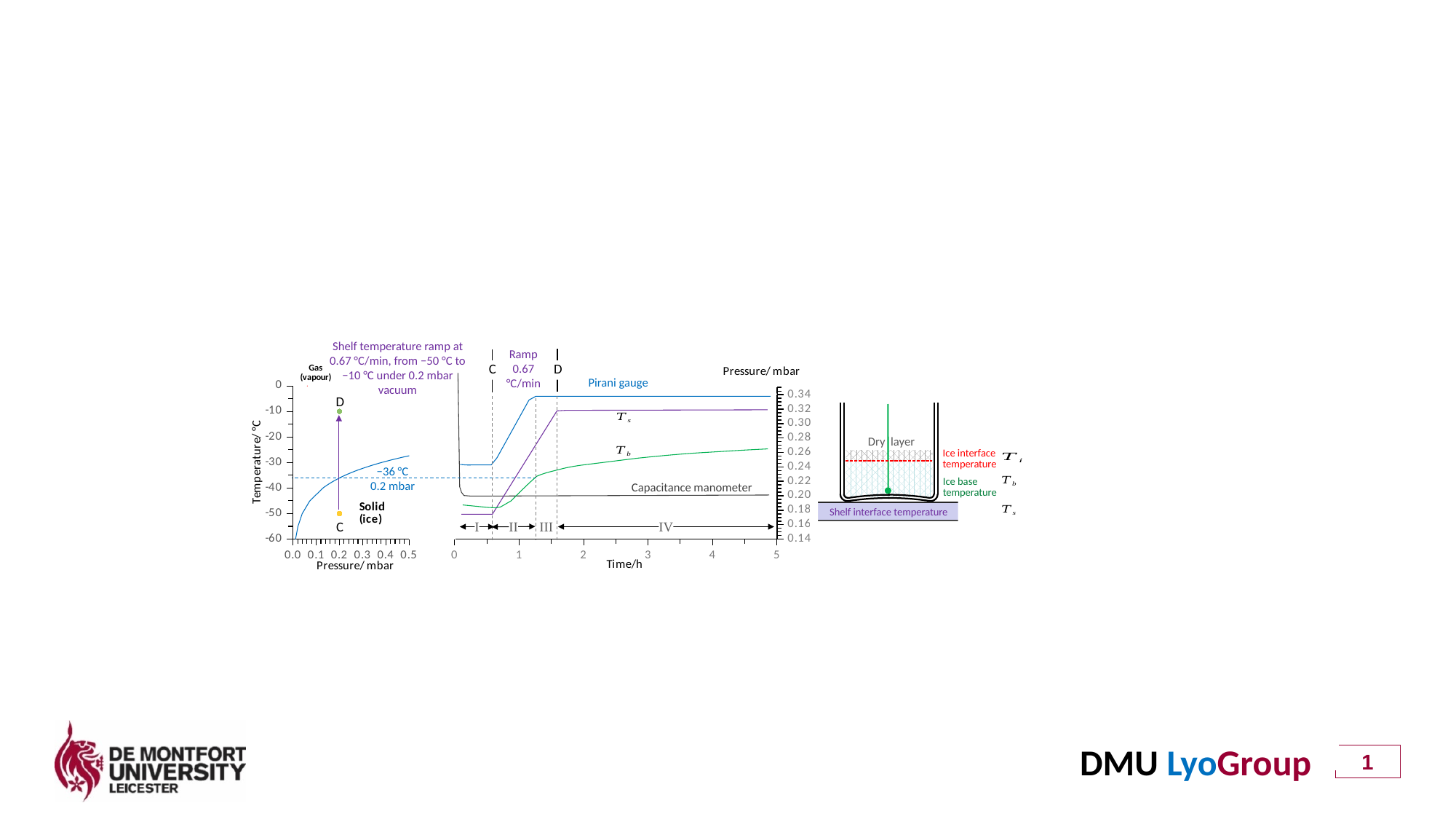
On the left chart, what temperature does the horizontal dashed line mark? −36 °C What kind of chart is the left chart with Temperature/°C against Pressure/mbar? line chart On the right chart (Time/h), does the Tb curve rise or fall between 2 h and 5 h? rise On the left chart, at what temperature is point D plotted? −10 °C On the left chart, at what pressure do points C and D lie? 0.2 mbar On the left chart, at what temperature is point C plotted? −50 °C On the right chart (Time/h), is the Pirani gauge value at 4 h greater or less than 0.32 mbar? greater On the right chart (Time/h), which curve is highest at 5 h? Pirani gauge On the right chart (Time/h), which curve is higher at 3 h, Ts or Tb? Ts On the right chart (Time/h), is the Capacitance manometer value at 4 h greater or less than 0.22 mbar? less On the left chart, what is the difference in temperature between point D and point C? 40 °C On the right chart (Time/h), how many Roman-numeral regions are marked along the time axis? 4